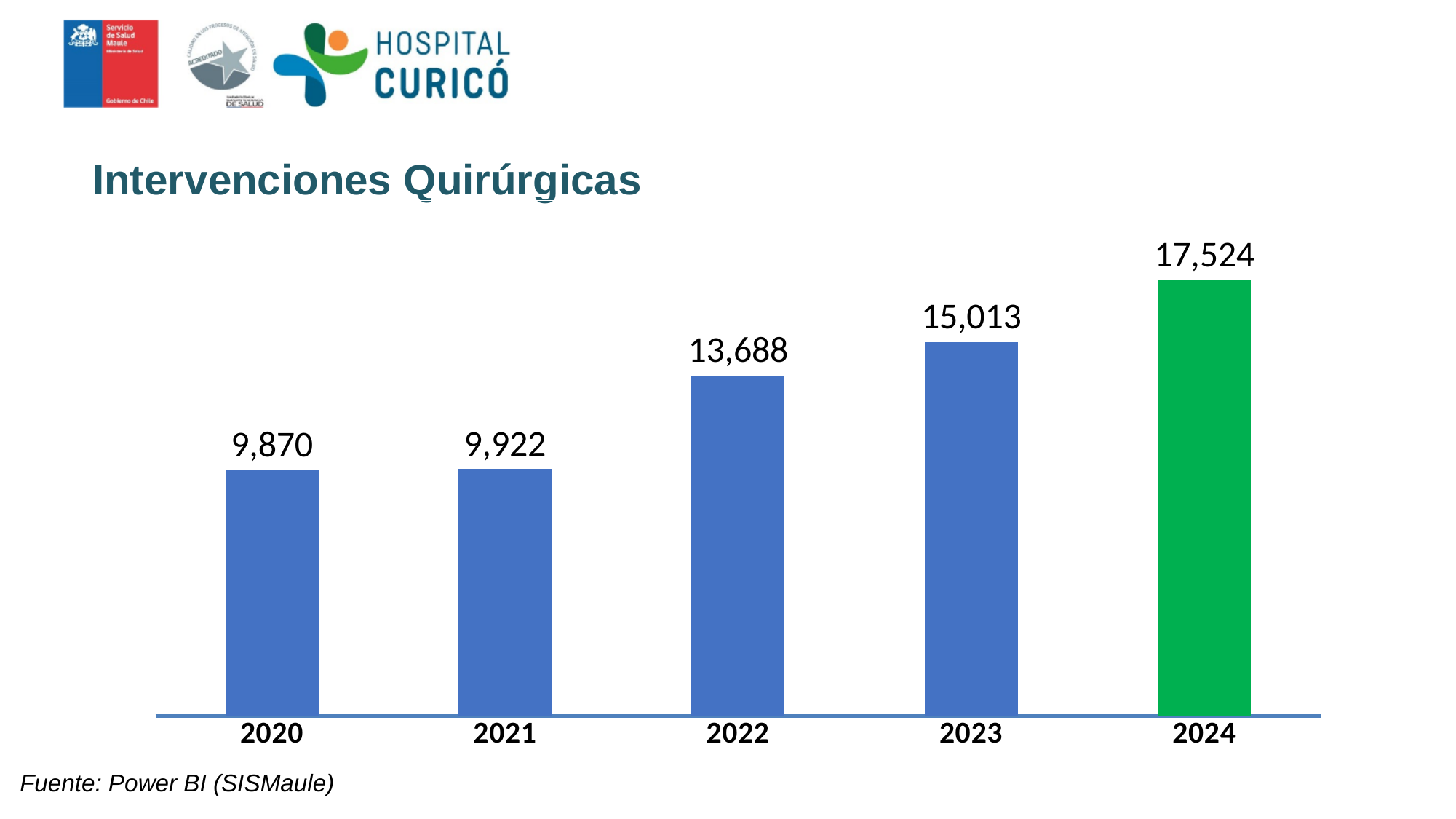
Do the values rise or fall from 2020 to 2024? Rise What is the title of the chart? Intervenciones Quirúrgicas What is the value for 2024? 17,524 What is the difference between the values for 2024 and 2023? 2,511 What is the value for 2020? 9,870 Which is larger, the value for 2023 or the value for 2022? 2023 What is the difference between the values for 2022 and 2021? 3,766 What is the value for 2022? 13,688 How many years are shown on the chart? 5 Which year has the highest value? 2024 Which year has the lowest value? 2020 What kind of chart is shown on the slide? Bar chart